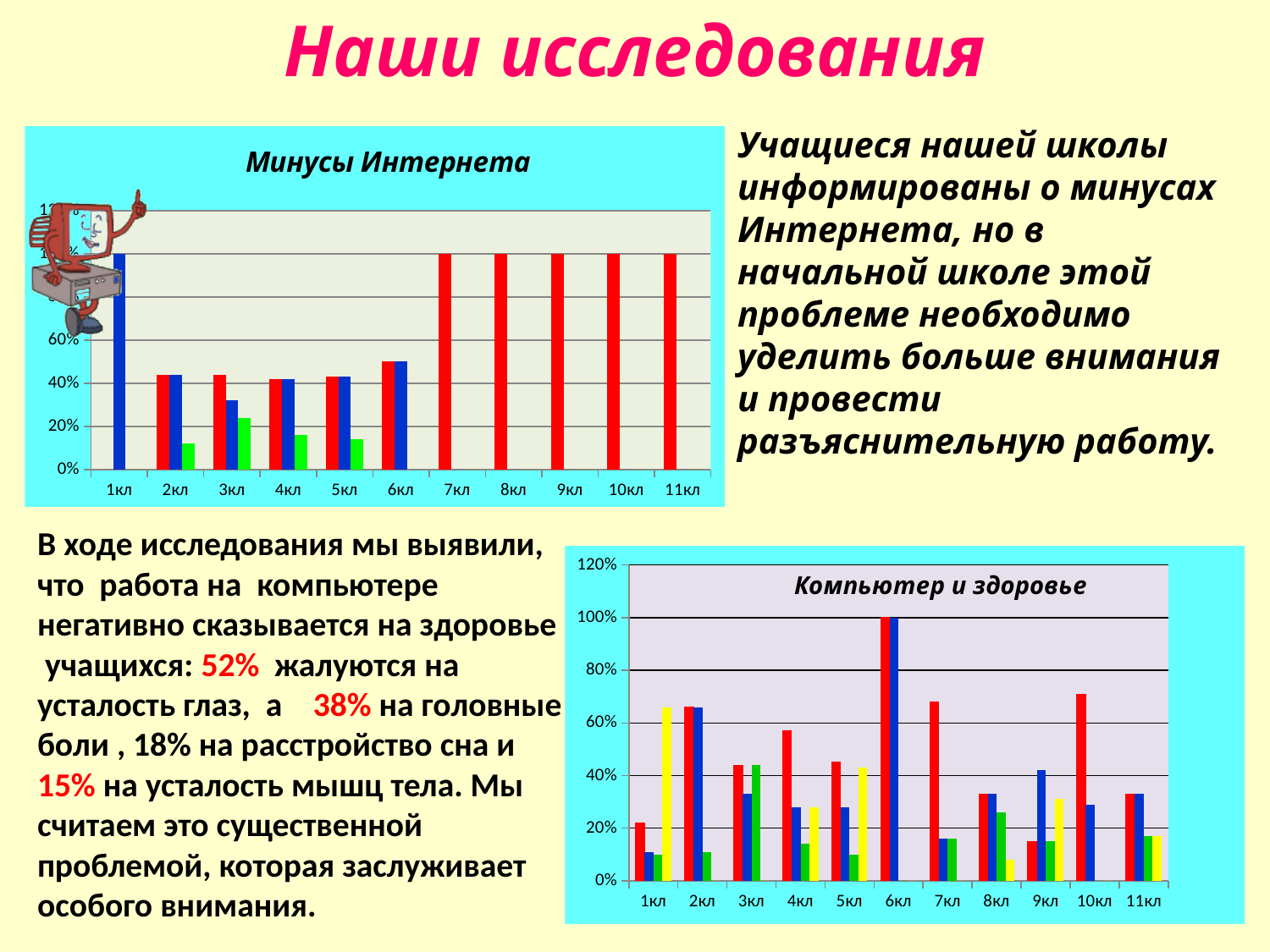
How many categories are shown on the x axis of the "Компьютер и здоровье" chart? 11 In the "Минусы Интернета" chart, is the value of the red bar for 6кл greater or less than 60%? less In the "Минусы Интернета" chart, what colour are the bars for 7кл through 11кл? red What kind of chart is the "Компьютер и здоровье" chart? bar chart In the "Минусы Интернета" chart, is the value of the green bar for 4кл greater or less than 20%? less How many categories are shown on the x axis of the "Минусы Интернета" chart? 11 In the "Компьютер и здоровье" chart, what is the value of the red bar for 6кл? 100% What kind of chart is the "Минусы Интернета" chart? bar chart In the "Компьютер и здоровье" chart, is the value of the red bar for 8кл greater or less than 40%? less In the "Компьютер и здоровье" chart, which category has the tallest red bar? 6кл In the "Компьютер и здоровье" chart, is the red bar for 7кл taller than the red bar for 8кл? yes